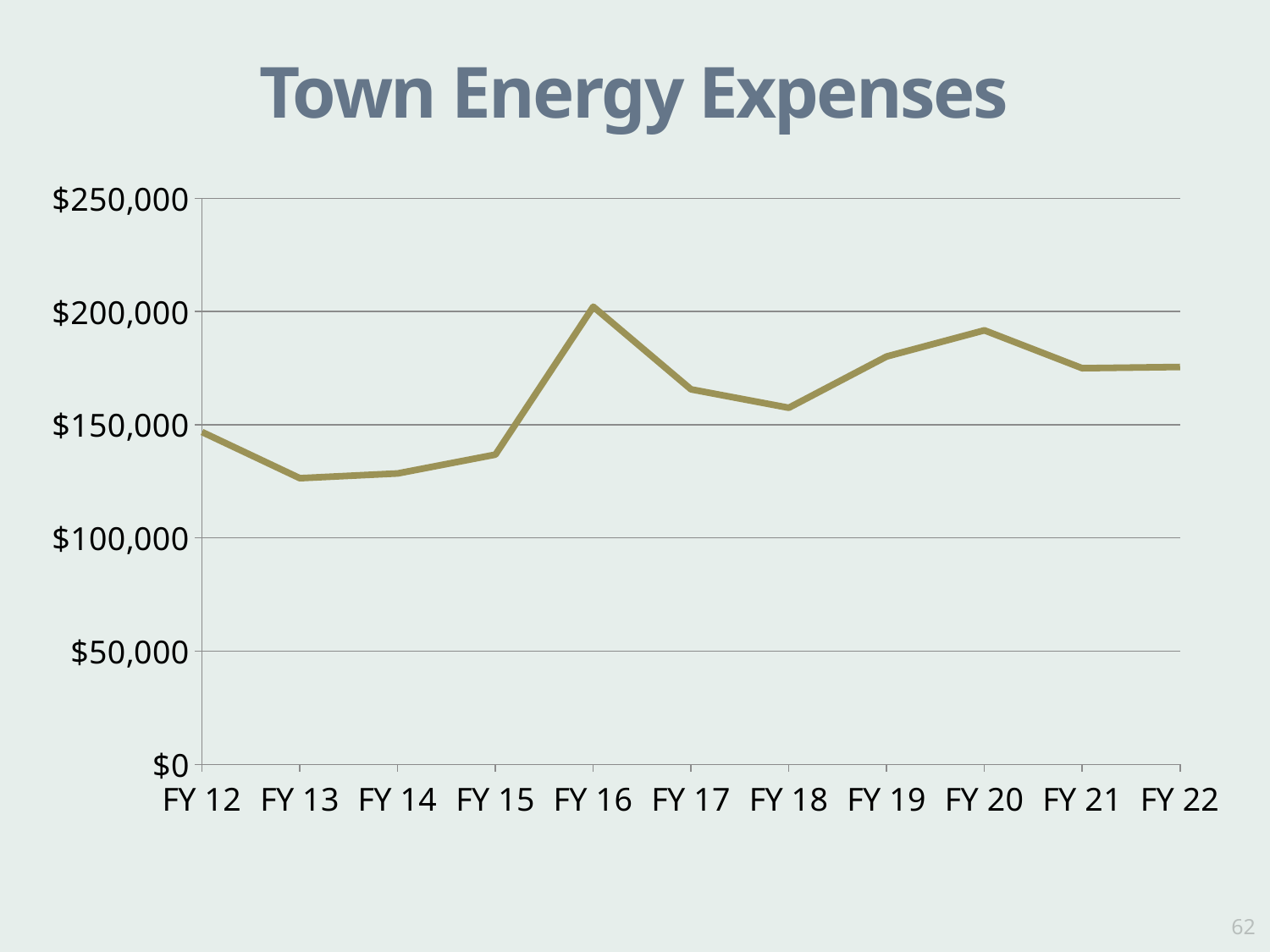
Which is larger, the value for FY 13 or the value for FY 19? FY 19 Which fiscal year has the highest energy expense? FY 16 What is the title of the chart? Town Energy Expenses Is the value for FY 20 greater or less than $200,000? less What kind of chart is shown on the slide? line chart Is the value for FY 19 greater or less than $150,000? greater How many fiscal years are plotted on the x axis? 11 Is the value for FY 13 greater or less than $150,000? less Do the values rise or fall from FY 13 to FY 16? rise Which is larger, the value for FY 16 or the value for FY 20? FY 16